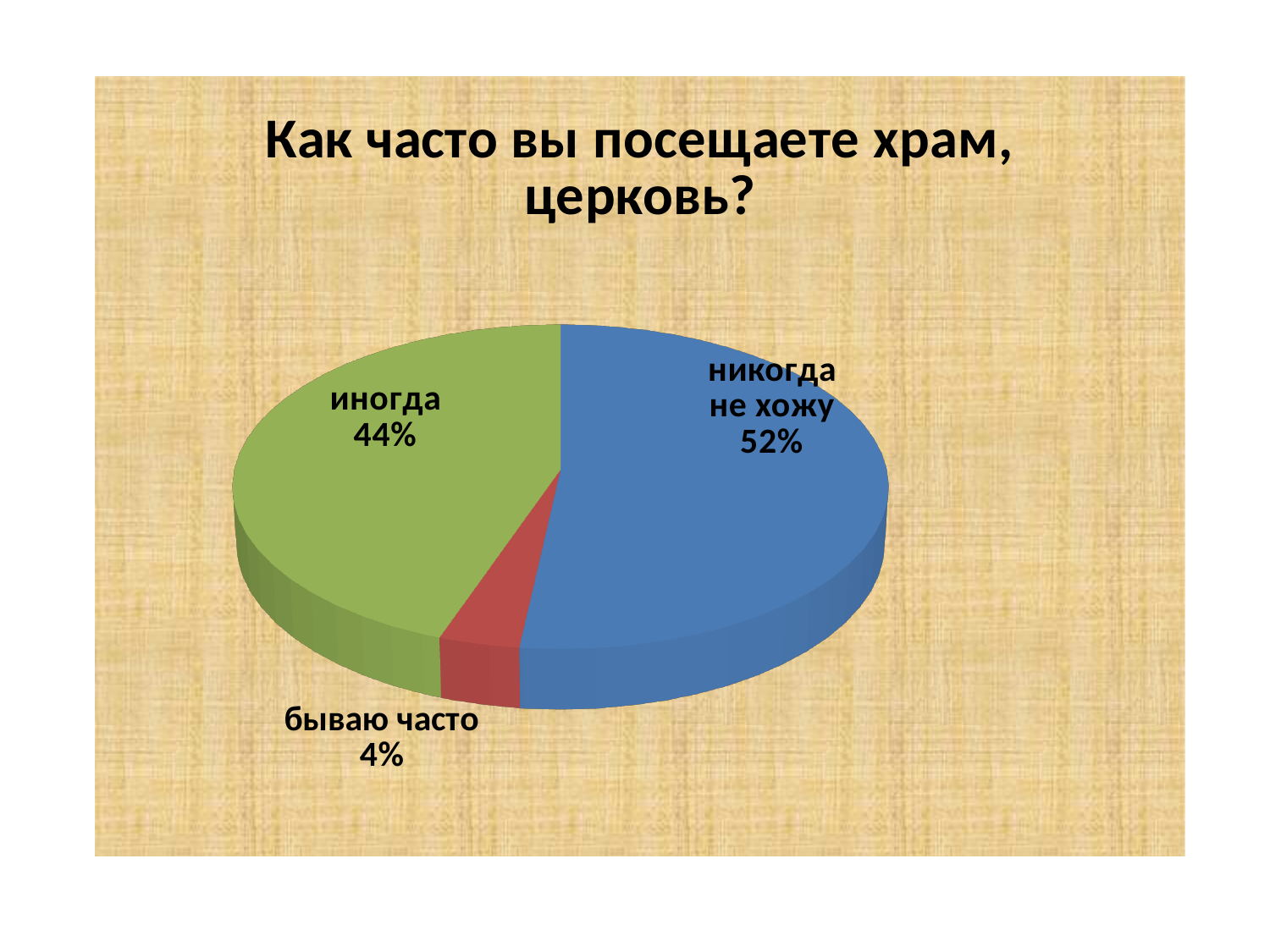
What is the difference in percentage points between "никогда не хожу" and "иногда"? 8% Which is larger, the slice for "иногда" or the slice for "бываю часто"? иногда Which category has the smallest slice? бываю часто What is the title of the chart? Как часто вы посещаете храм, церковь? What share of the pie does "бываю часто" take? 4% What kind of chart is shown on the slide? pie chart Which category has the largest slice? никогда не хожу How many slices does the pie chart have? 3 What share of the pie does "никогда не хожу" take? 52% What is the difference in percentage points between "иногда" and "бываю часто"? 40% What share of the pie does "иногда" take? 44% What colour is the slice for "никогда не хожу"? blue